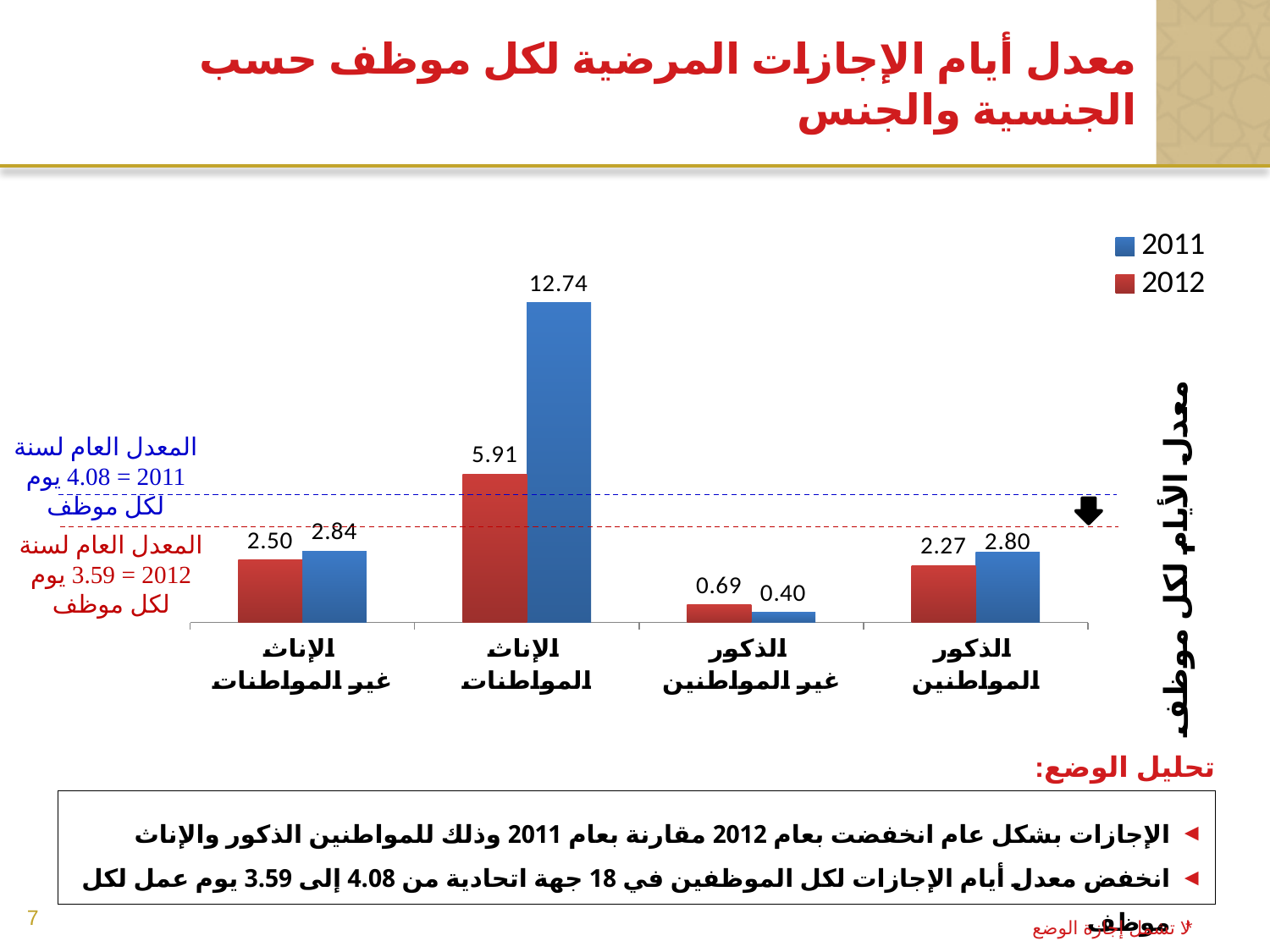
Which category has the lowest 2012 value? الذكور غير المواطنين Which category has the highest 2011 value? الإناث المواطنات How many series does the legend list? 2 How many categories are shown on the x axis? 4 For الذكور غير المواطنين, which year has the larger value, 2011 or 2012? 2012 What is the 2011 value for الذكور المواطنين? 2.80 What is the 2011 value for الإناث المواطنات? 12.74 What is the 2012 value for الذكور غير المواطنين? 0.69 What is the 2012 value for الإناث غير المواطنات? 2.50 What is the difference between the 2011 and 2012 values for الإناث المواطنات? 6.83 What kind of chart is shown on the slide? Bar chart Which colour represents the 2012 series in the legend? Red